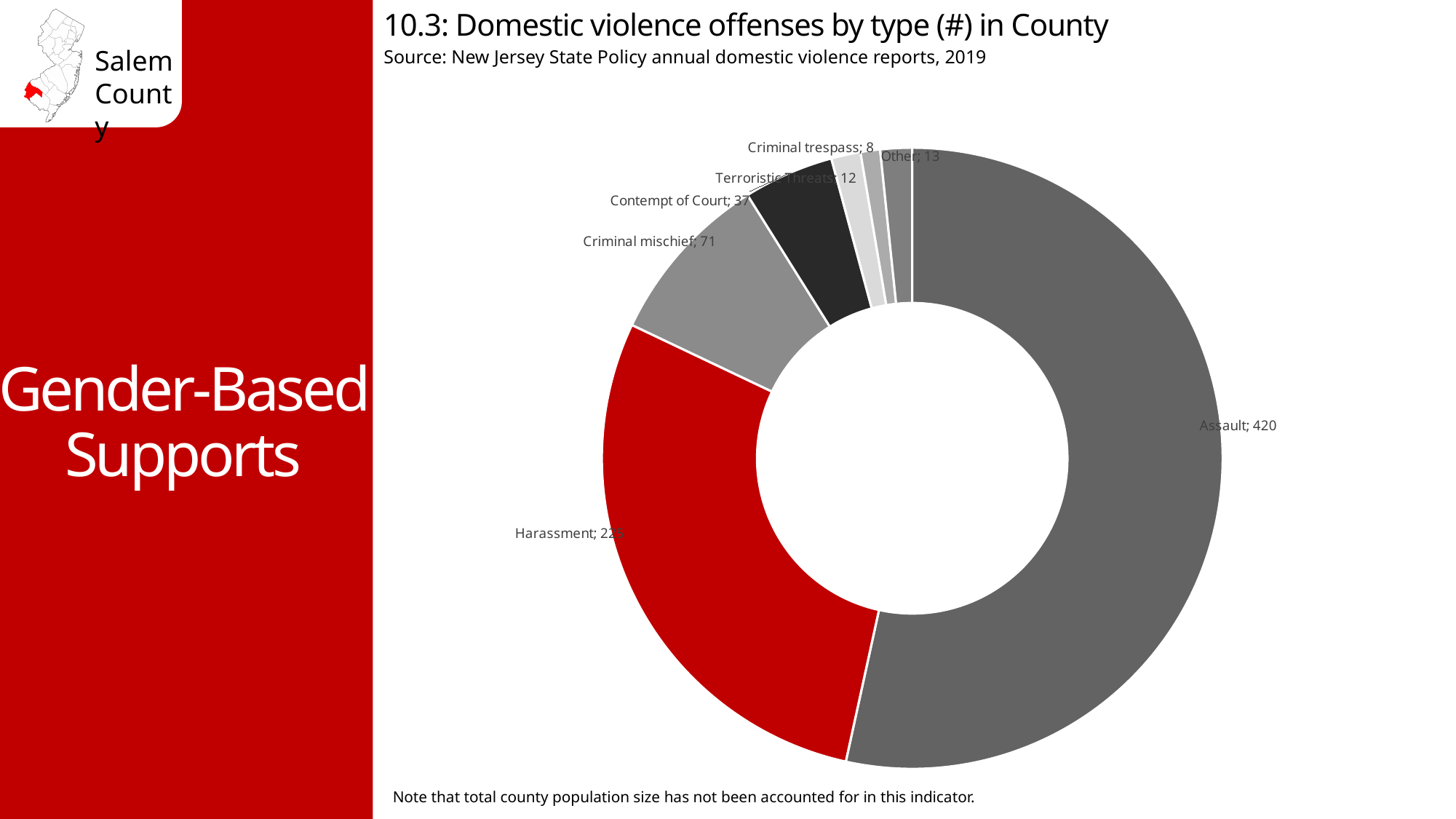
What is the difference between the number of Assault offenses and Criminal mischief offenses? 349 What is the number of offenses in the Other category? 13 What is the number of Criminal trespass offenses? 8 What colour is the Harassment slice of the chart? Red Which offense type has the smallest number of offenses? Criminal trespass How many offense types are shown in the chart? 7 What is the number of Criminal mischief offenses? 71 What is the number of Assault offenses? 420 Which is larger, the number of Assault offenses or the number of Harassment offenses? Assault What type of chart is shown on the slide? Pie chart (donut) Which offense type has the largest number of offenses? Assault What is the number of Terroristic Threats offenses? 12